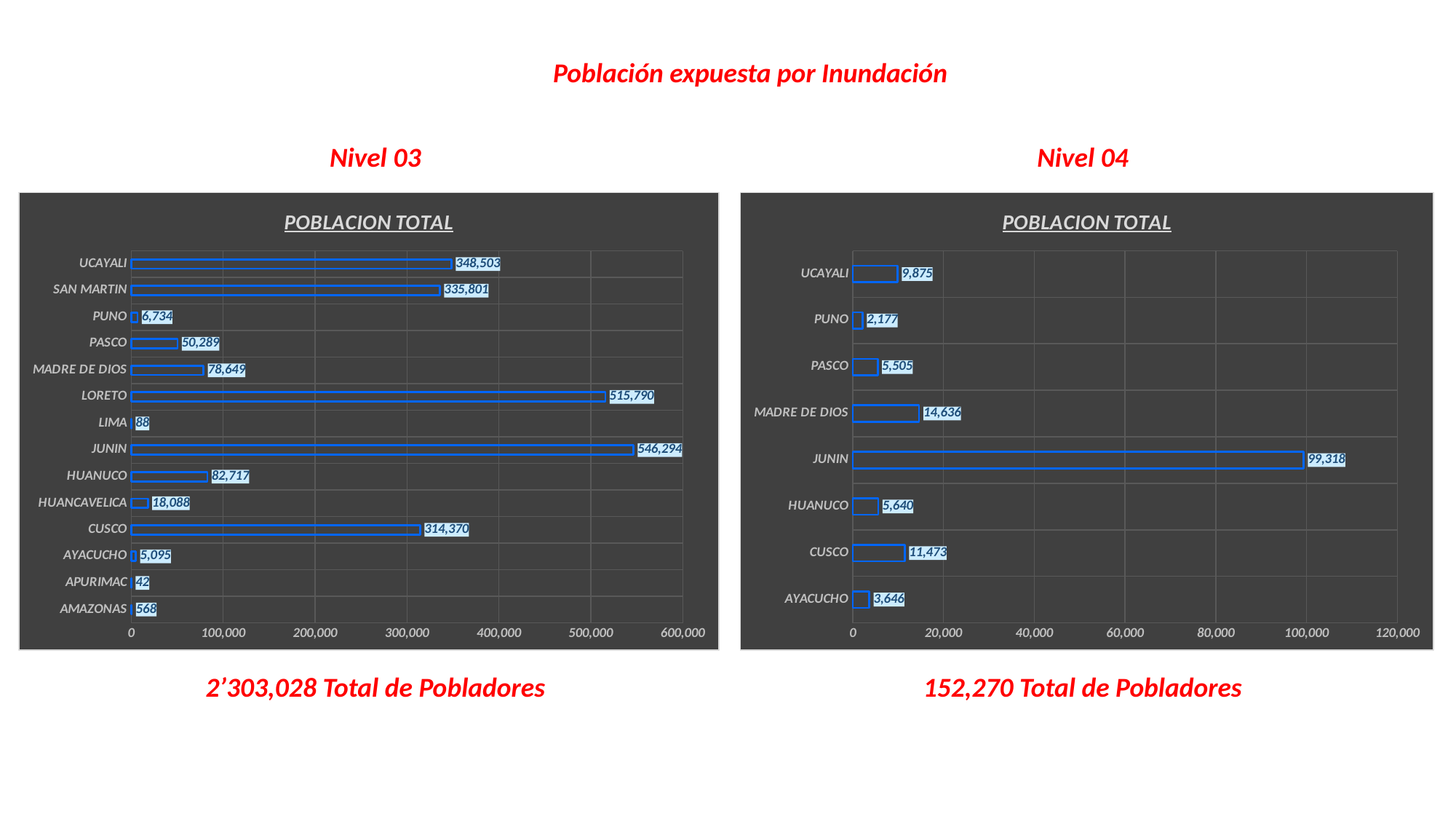
In the Nivel 04 chart on the right, is the value for JUNIN greater or less than 80,000? greater In the Nivel 03 chart on the left, which category has the lowest value? APURIMAC In the Nivel 03 chart on the left, what is the difference between the values for JUNIN and LORETO? 30,504 In the Nivel 04 chart on the right, what is the value for MADRE DE DIOS? 14,636 What kind of chart is the Nivel 04 chart on the right? Bar chart How many categories are shown in the Nivel 03 chart on the left? 14 In the Nivel 04 chart on the right, what is the difference between the values for MADRE DE DIOS and CUSCO? 3,163 In the Nivel 04 chart on the right, which category has the lowest value? PUNO How many categories are shown in the Nivel 04 chart on the right? 8 In the Nivel 03 chart on the left, which is larger, the value for UCAYALI or the value for SAN MARTIN? UCAYALI In the Nivel 03 chart on the left, which category has the highest value? JUNIN In the Nivel 03 chart on the left, what is the value for LORETO? 515,790